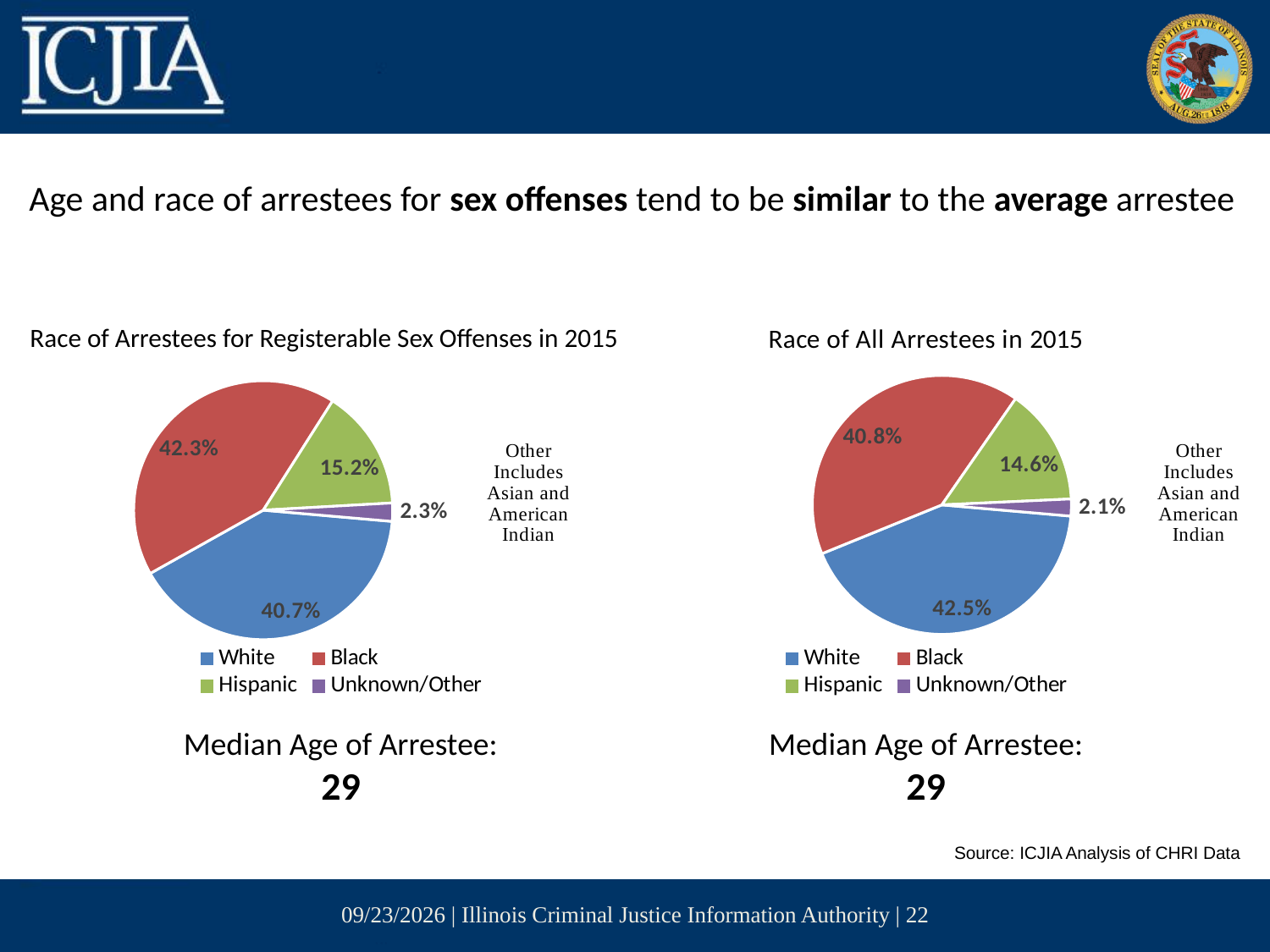
In the 'Race of All Arrestees in 2015' chart, what percentage of arrestees are White? 42.5% In the 'Race of All Arrestees in 2015' chart, which colour represents the Hispanic category? Green What type of chart is used to show the 'Race of Arrestees for Registerable Sex Offenses in 2015'? Pie chart In the 'Race of Arrestees for Registerable Sex Offenses in 2015' chart, what percentage of arrestees are Hispanic? 15.2% In the 'Race of Arrestees for Registerable Sex Offenses in 2015' chart, what percentage of arrestees are Black? 42.3% In the 'Race of Arrestees for Registerable Sex Offenses in 2015' chart, which race category has the largest share? Black In the 'Race of All Arrestees in 2015' chart, which race category has the smallest share? Unknown/Other Is the Hispanic share larger in the 'Race of Arrestees for Registerable Sex Offenses in 2015' chart or in the 'Race of All Arrestees in 2015' chart? Race of Arrestees for Registerable Sex Offenses in 2015 In the 'Race of All Arrestees in 2015' chart, what is the difference in percentage points between the White and Hispanic shares? 27.9 How many race categories are shown in the 'Race of All Arrestees in 2015' chart? 4 In the 'Race of All Arrestees in 2015' chart, what percentage of arrestees are Unknown/Other? 2.1% In the 'Race of Arrestees for Registerable Sex Offenses in 2015' chart, what is the difference in percentage points between the Black and White shares? 1.6